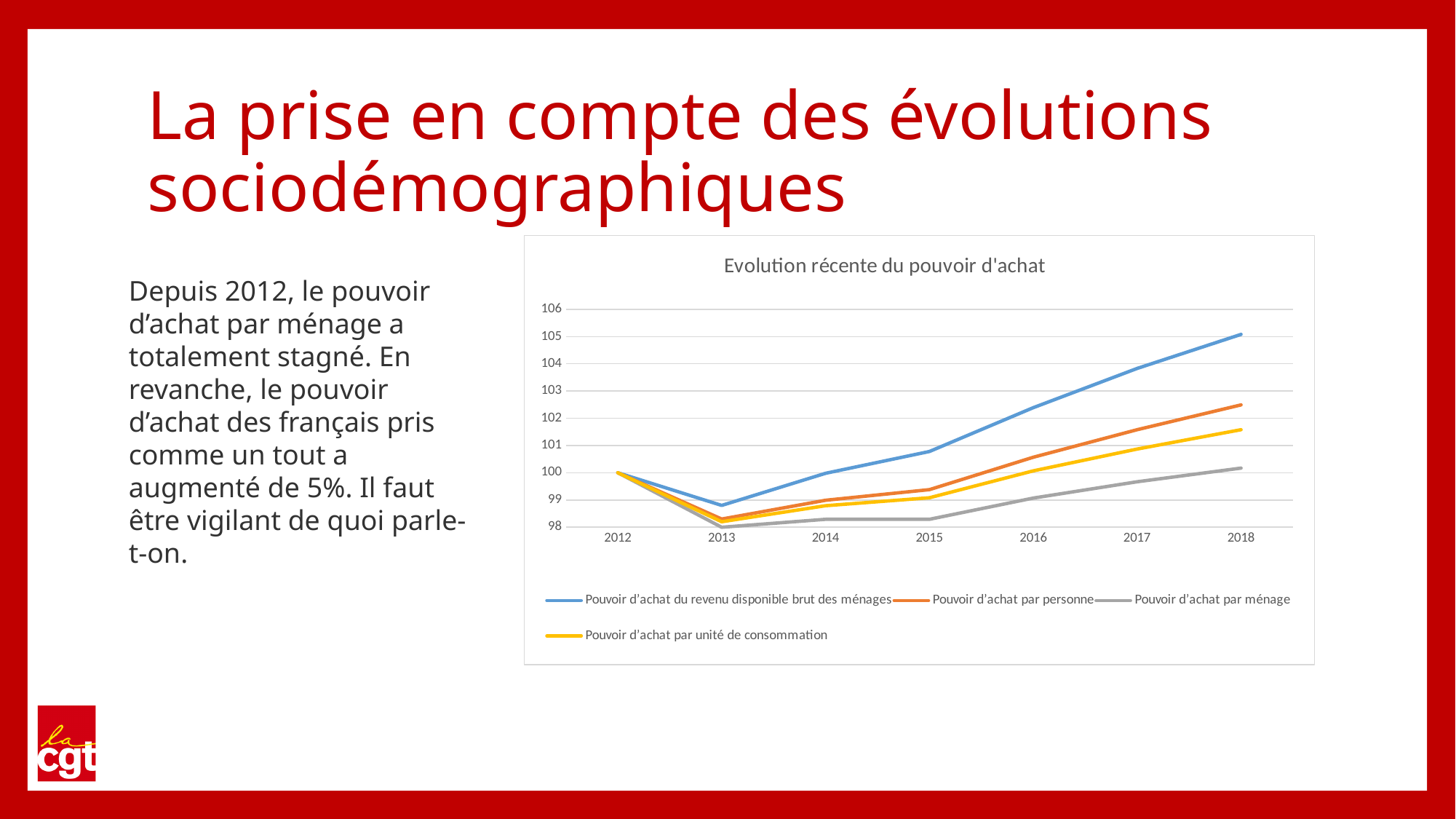
Is the value for Pouvoir d'achat du revenu disponible brut des ménages in 2018 greater or less than 104? greater From 2013 to 2018, does the Pouvoir d'achat du revenu disponible brut des ménages line rise or fall? rise How many series does the legend of the chart list? 4 Is the value for Pouvoir d'achat par ménage in 2018 greater or less than 101? less What kind of chart is shown on the slide? line chart In 2018, which is larger: Pouvoir d'achat par personne or Pouvoir d'achat par unité de consommation? Pouvoir d'achat par personne What is the value of Pouvoir d'achat par ménage in 2012? 100 In which year does the Pouvoir d'achat du revenu disponible brut des ménages series reach its lowest value? 2013 Which series has the lowest value in 2018? Pouvoir d'achat par ménage Which series has the highest value in 2018? Pouvoir d'achat du revenu disponible brut des ménages What is the title of the chart? Evolution récente du pouvoir d'achat How many years are plotted along the x axis of the chart? 7